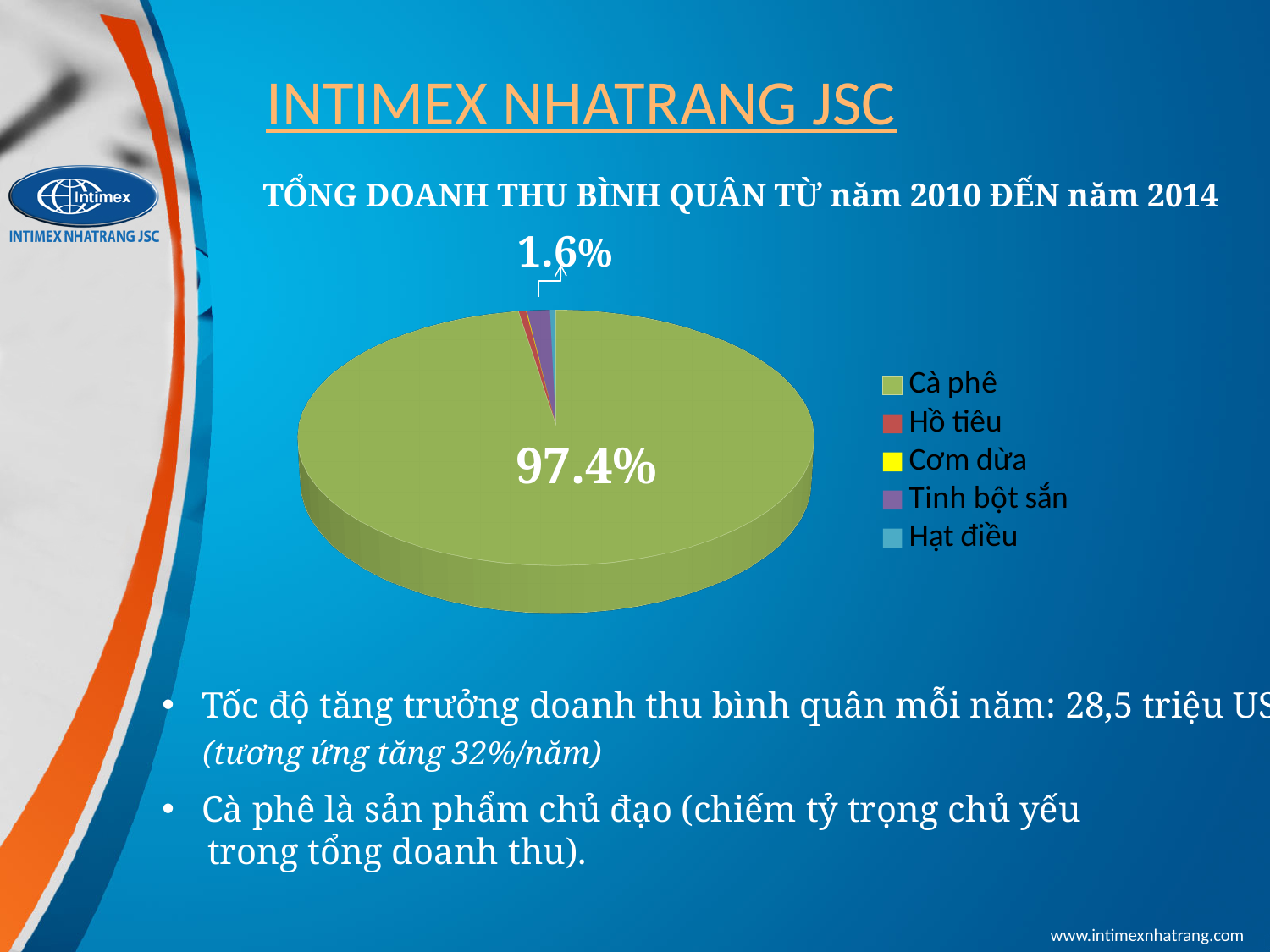
Which category is listed last in the legend? Hạt điều What is the smaller percentage value printed on the chart? 1.6% What type of chart is shown on the slide? Pie chart What is the title of the chart? TỔNG DOANH THU BÌNH QUÂN TỪ năm 2010 ĐẾN năm 2014 Which category has the largest slice of the pie? Cà phê What colour is the Cà phê slice in the pie chart? Green Which is larger, the slice for Cà phê or the slice for Hồ tiêu? Cà phê What share of the pie does Cà phê account for? 97.4% How many categories does the legend list? 5 Which is larger, the slice for Cà phê or the slice for Hạt điều? Cà phê